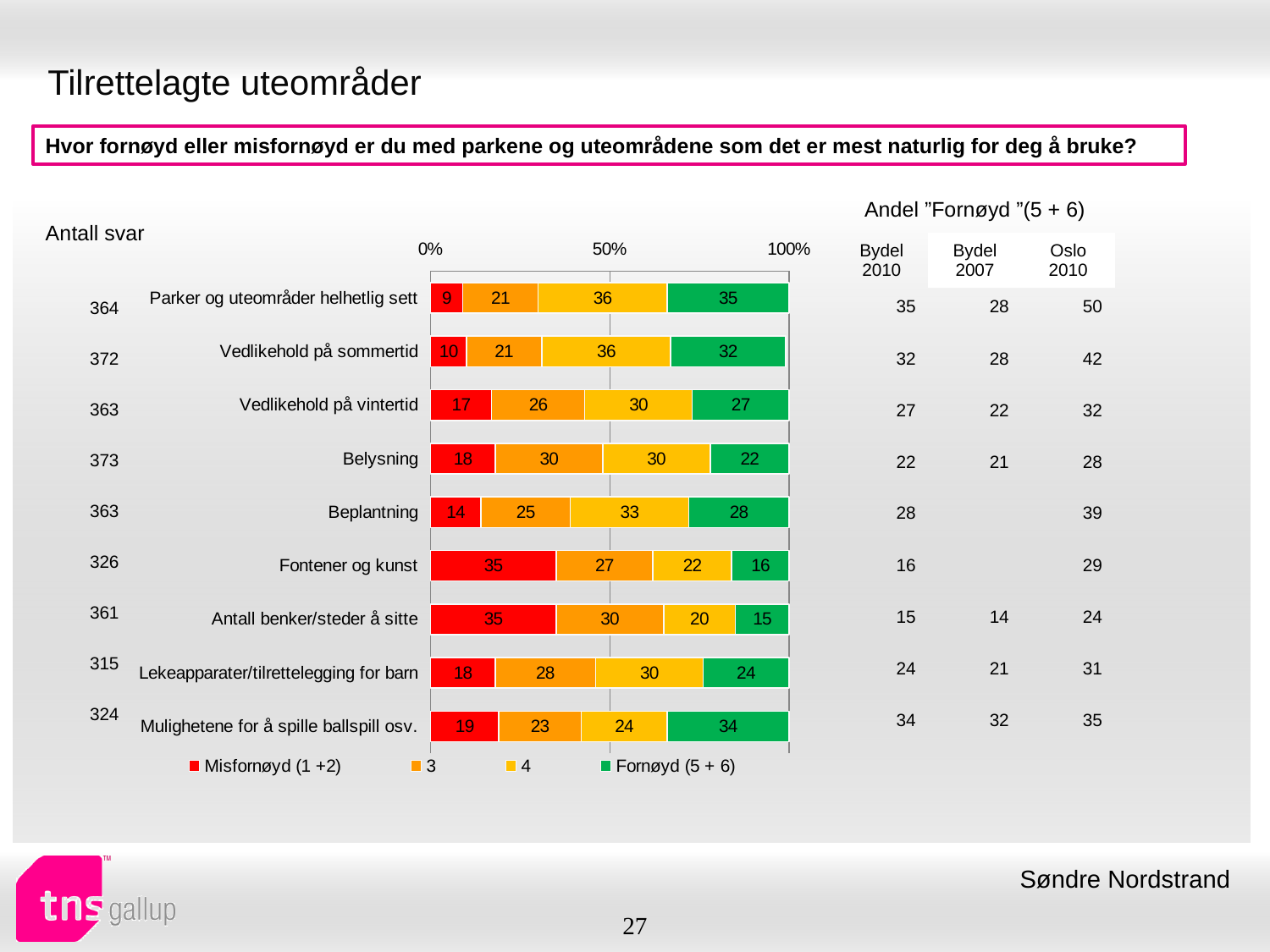
What is the value of the Fornøyd (5 + 6) series for Parker og uteområder helhetlig sett? 35 What is the value of the Misfornøyd (1 +2) series for Fontener og kunst? 35 What is the value of the series labelled 4 for Mulighetene for å spille ballspill osv.? 24 How many series does the chart legend list? 4 What is the difference between the Fornøyd (5 + 6) values for Parker og uteområder helhetlig sett and Belysning? 13 What is the difference between the Misfornøyd (1 +2) values for Fontener og kunst and Parker og uteområder helhetlig sett? 26 How many categories are shown in the chart? 9 Which has a larger Fornøyd (5 + 6) value, Beplantning or Belysning? Beplantning What kind of chart is shown on the slide? Stacked bar chart Which category has the lowest value for the series labelled 4? Antall benker/steder å sitte Which category has the lowest value for the Misfornøyd (1 +2) series? Parker og uteområder helhetlig sett What is the value of the series labelled 3 for Belysning? 30